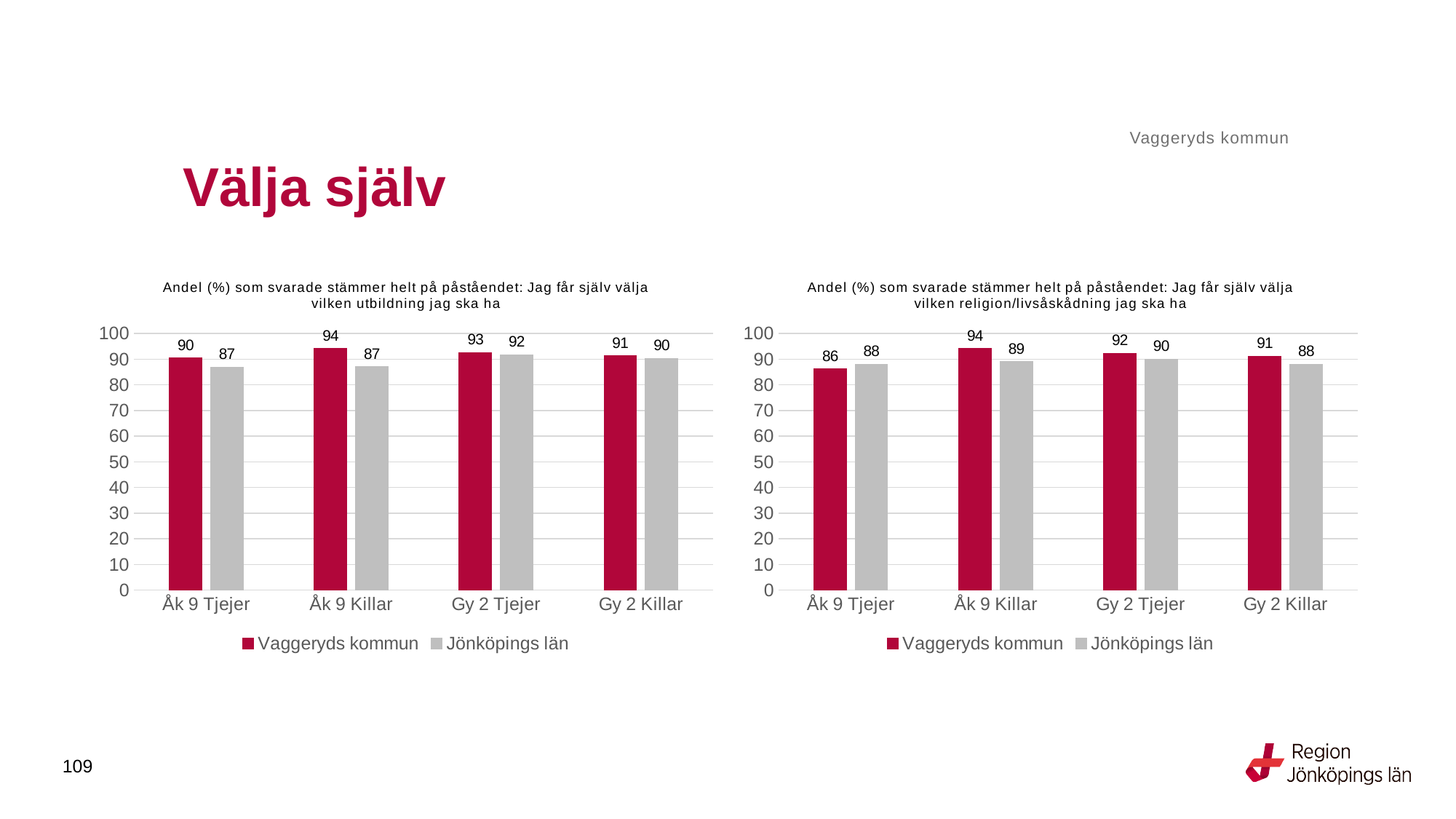
In the right chart (about choosing religion), what is the value for Jönköpings län for Gy 2 Killar? 88 What kind of chart is the left chart? Bar chart How many categories are shown on the x axis of the left chart? 4 In the right chart (about choosing religion), what is the difference between Vaggeryds kommun and Jönköpings län for Åk 9 Killar? 5 In the right chart (about choosing religion), which category has the lowest value for Vaggeryds kommun? Åk 9 Tjejer In the left chart (about choosing education), what is the difference between Vaggeryds kommun and Jönköpings län for Åk 9 Killar? 7 In the left chart (about choosing education), which category has the highest value for Vaggeryds kommun? Åk 9 Killar In the right chart (about choosing religion), which is larger for Åk 9 Tjejer: Vaggeryds kommun or Jönköpings län? Jönköpings län In the left chart (about choosing education), what is the value for Vaggeryds kommun for Åk 9 Killar? 94 In the right chart (about choosing religion), what is the value for Vaggeryds kommun for Åk 9 Tjejer? 86 In the left chart (about choosing education), what is the value for Jönköpings län for Gy 2 Tjejer? 92 How many series does the legend of the right chart list? 2